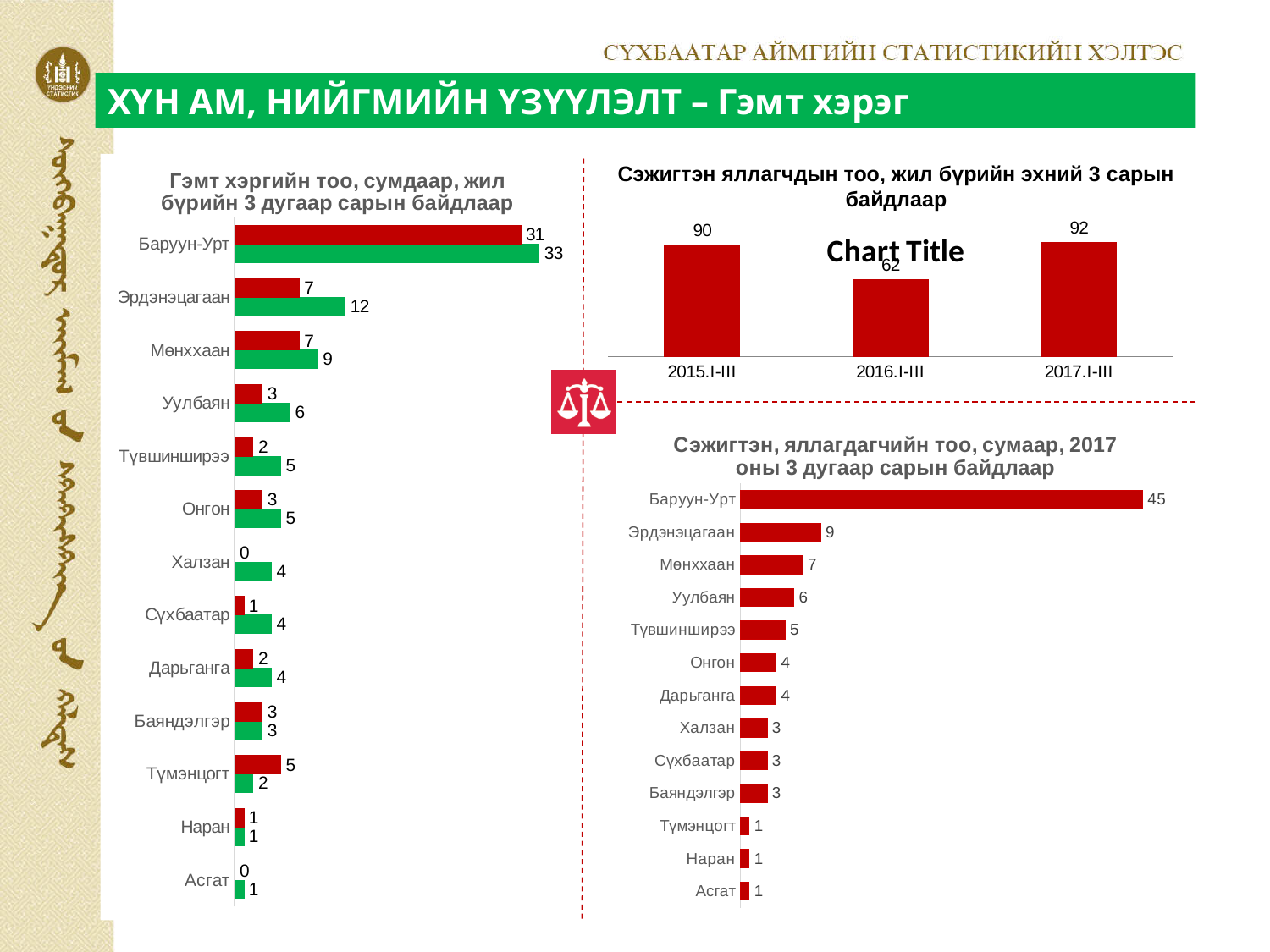
How many categories are shown in the bottom-right chart 'Сэжигтэн, яллагдагчийн тоо, сумаар, 2017 оны 3 дугаар сарын байдлаар'? 13 What type of chart is the bottom-right chart 'Сэжигтэн, яллагдагчийн тоо, сумаар, 2017 оны 3 дугаар сарын байдлаар'? Bar chart In the top-right chart 'Сэжигтэн яллагчдын тоо, жил бүрийн эхний 3 сарын байдлаар', what is the difference between the 2017.I-III and 2015.I-III values? 2 In the top-right chart 'Сэжигтэн яллагчдын тоо, жил бүрийн эхний 3 сарын байдлаар', which period has the highest value? 2017.I-III How many bars are in the top-right chart 'Сэжигтэн яллагчдын тоо, жил бүрийн эхний 3 сарын байдлаар'? 3 In the left chart 'Гэмт хэргийн тоо, сумдаар', which category has the highest red bar value? Баруун-Урт In the bottom-right chart 'Сэжигтэн, яллагдагчийн тоо, сумаар, 2017 оны 3 дугаар сарын байдлаар', what is the value for Уулбаян? 6 In the bottom-right chart 'Сэжигтэн, яллагдагчийн тоо, сумаар, 2017 оны 3 дугаар сарын байдлаар', which is larger: Эрдэнэцагаан or Мөнххаан? Эрдэнэцагаан In the top-right chart 'Сэжигтэн яллагчдын тоо, жил бүрийн эхний 3 сарын байдлаар', what is the value for 2016.I-III? 62 In the bottom-right chart 'Сэжигтэн, яллагдагчийн тоо, сумаар, 2017 оны 3 дугаар сарын байдлаар', what is the value for Баруун-Урт? 45 In the left chart 'Гэмт хэргийн тоо, сумдаар', what is the difference between the green and red bar values for Баруун-Урт? 2 In the left chart 'Гэмт хэргийн тоо, сумдаар', what is the green bar value for Эрдэнэцагаан? 12